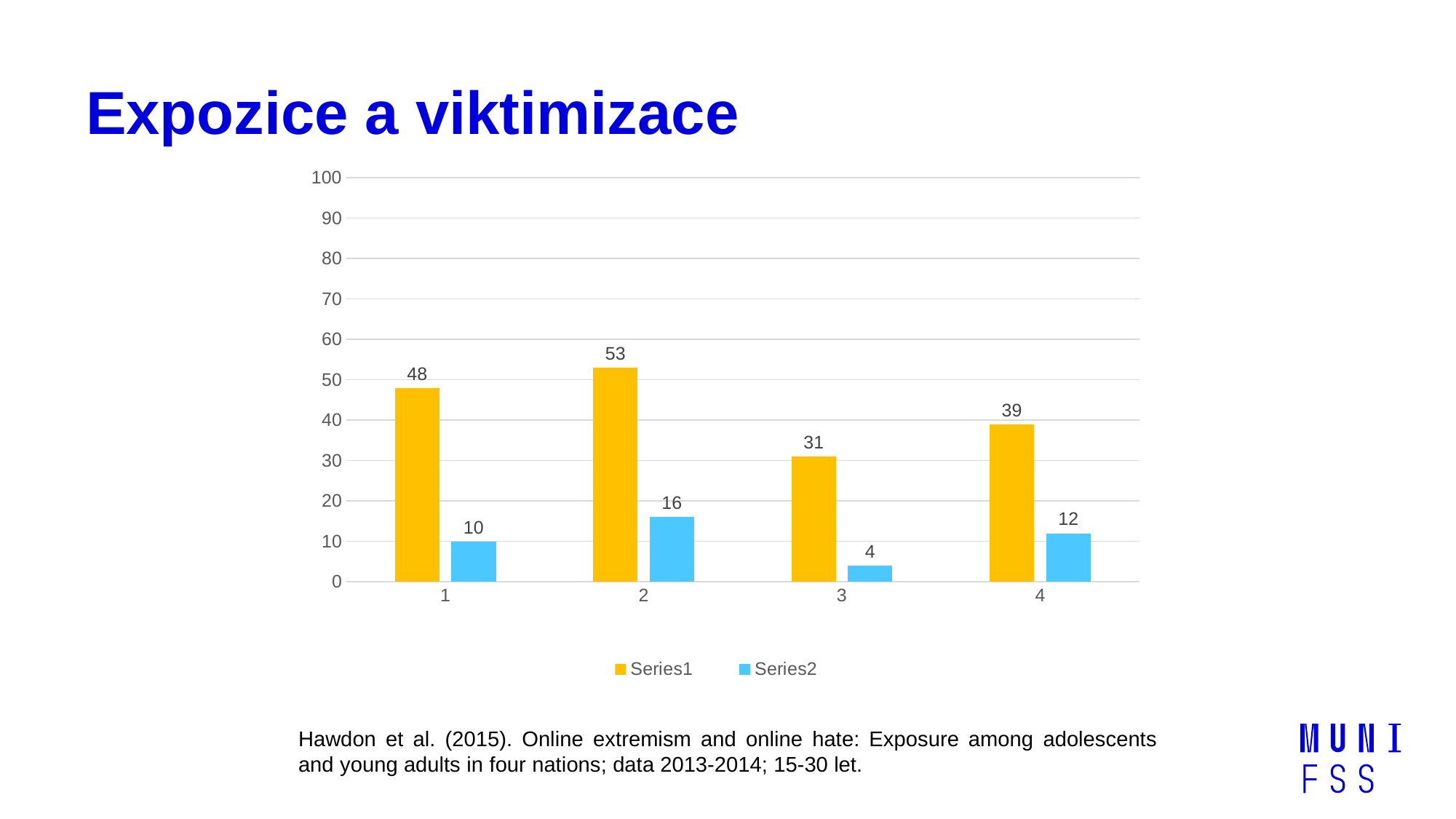
How many categories are shown on the x axis? 4 Which category has the highest Series1 value? 2 What colour are the Series2 bars? light blue What is the Series1 value for category 4? 39 What is the Series2 value for category 3? 4 How many series does the legend list? 2 Is the Series1 value for category 3 greater or less than 40? less What is the difference between the Series1 and Series2 values for category 1? 38 Which category has the lowest Series2 value? 3 Which is larger: the Series2 value for category 2 or the Series2 value for category 4? Series2 value for category 2 What kind of chart is shown on the slide? bar chart What is the Series1 value for category 2? 53